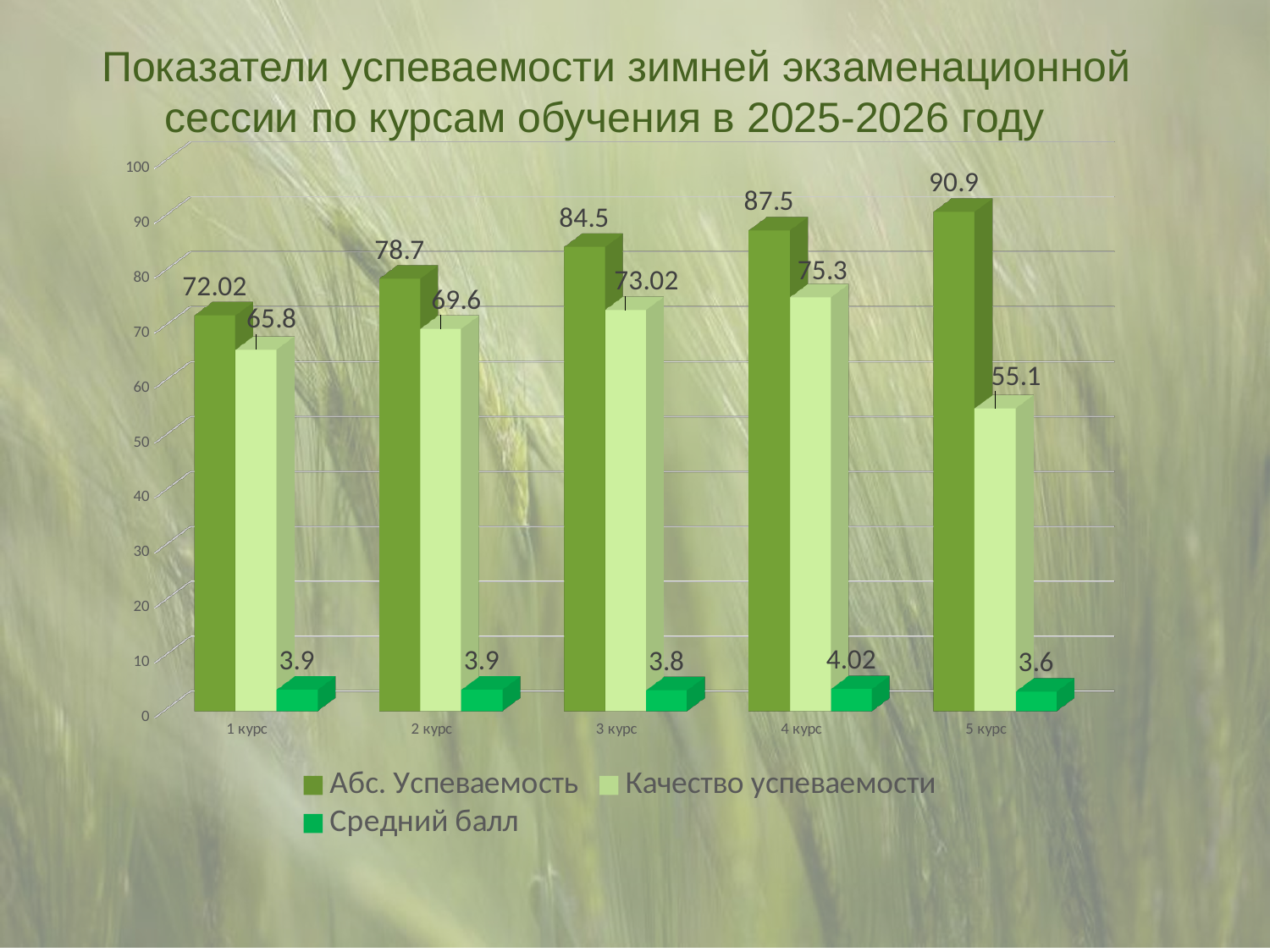
What kind of chart is shown on the slide? Bar chart How many courses (categories) are shown on the x axis? 5 Does Абс. Успеваемость rise or fall from 1 курс to 5 курс? Rises Which course has the lowest Качество успеваемости? 5 курс What is the Средний балл for 4 курс? 4.02 Which series is shown in the darkest green colour? Абс. Успеваемость How many series does the legend list? 3 What is the value of Качество успеваемости for 5 курс? 55.1 What is the value of Абс. Успеваемость for 3 курс? 84.5 Which course has the highest Абс. Успеваемость? 5 курс Which is larger: Качество успеваемости for 2 курс or for 4 курс? 4 курс What is the difference between Абс. Успеваемость and Качество успеваемости for 5 курс? 35.8